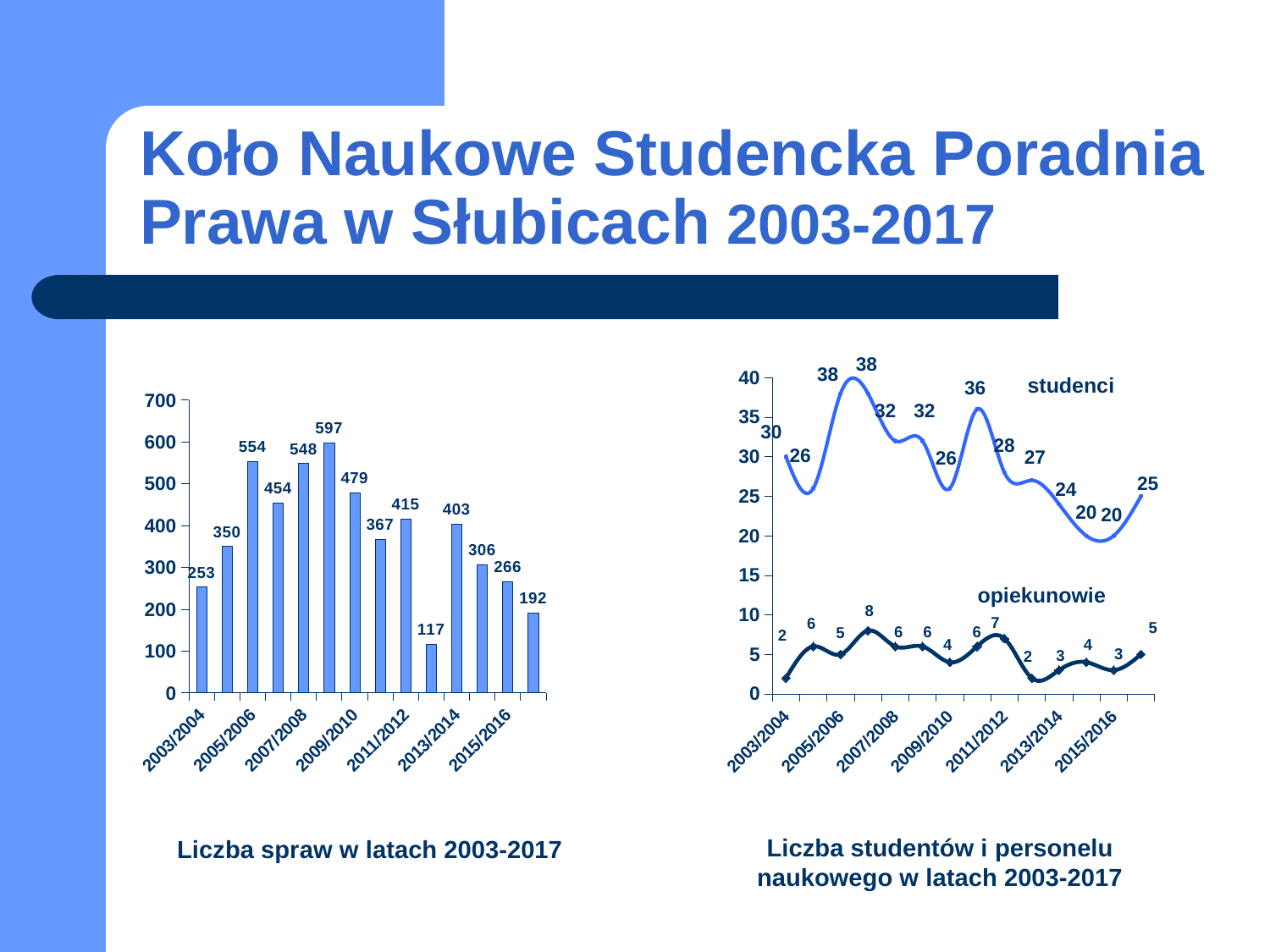
In the right chart 'Liczba studentów i personelu naukowego w latach 2003-2017', what is the highest value of the studenci series? 38 In the right chart 'Liczba studentów i personelu naukowego w latach 2003-2017', which year has the larger studenci value, 2003/2004 or 2015/2016? 2003/2004 In the right chart 'Liczba studentów i personelu naukowego w latach 2003-2017', what is the highest value of the opiekunowie series? 8 In the left chart 'Liczba spraw w latach 2003-2017', what is the lowest value shown? 117 How many series are plotted in the right chart 'Liczba studentów i personelu naukowego w latach 2003-2017'? 2 In the left chart 'Liczba spraw w latach 2003-2017', what is the difference between the values for 2005/2006 and 2007/2008? 6 In the right chart 'Liczba studentów i personelu naukowego w latach 2003-2017', what is the value for studenci in 2011/2012? 28 How many bars are plotted in the left chart 'Liczba spraw w latach 2003-2017'? 14 In the left chart 'Liczba spraw w latach 2003-2017', what is the highest value shown? 597 In the left chart 'Liczba spraw w latach 2003-2017', what is the value for 2003/2004? 253 What type of chart is the left chart, 'Liczba spraw w latach 2003-2017'? bar chart In the right chart 'Liczba studentów i personelu naukowego w latach 2003-2017', what is the value for opiekunowie in 2005/2006? 5